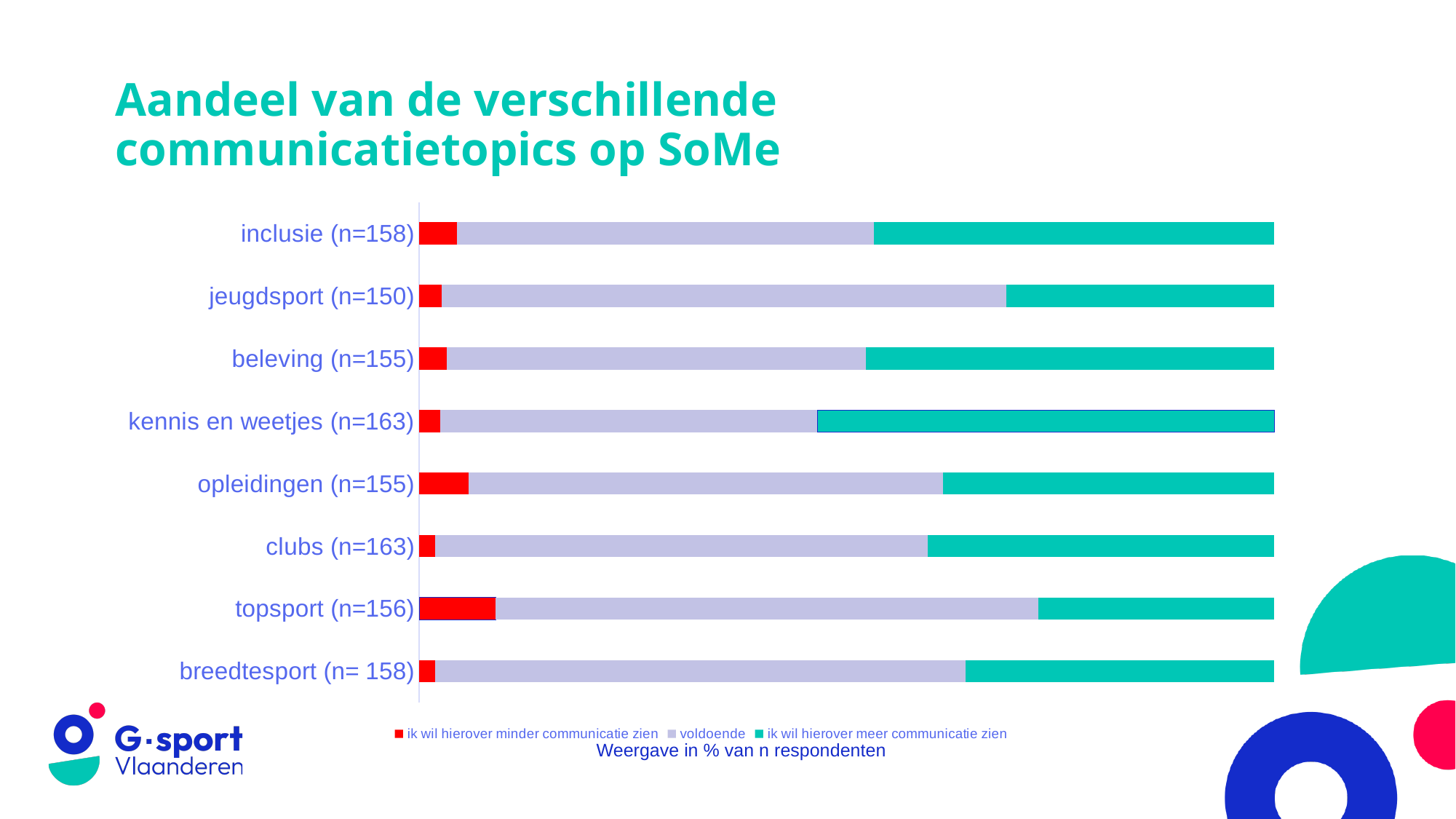
Which has a larger 'ik wil hierover minder communicatie zien' share: topsport or inclusie? topsport What are the three legend entries of the chart? ik wil hierover minder communicatie zien; voldoende; ik wil hierover meer communicatie zien Which has a larger 'ik wil hierover meer communicatie zien' share: kennis en weetjes or jeugdsport? kennis en weetjes Which topic has the largest share of respondents who want more communication (green segment)? kennis en weetjes (n=163) How many series does the legend list? 3 How many communication topics (categories) are shown on the chart? 8 Which topic has the smallest share of respondents who want more communication (green segment)? topsport (n=156) Which has a larger 'voldoende' share: jeugdsport or inclusie? jeugdsport What kind of chart is shown on the slide? stacked bar chart What is the number of respondents (n) given for the topsport category? 156 Which topic has the largest share of respondents who want less communication (red segment)? topsport (n=156)